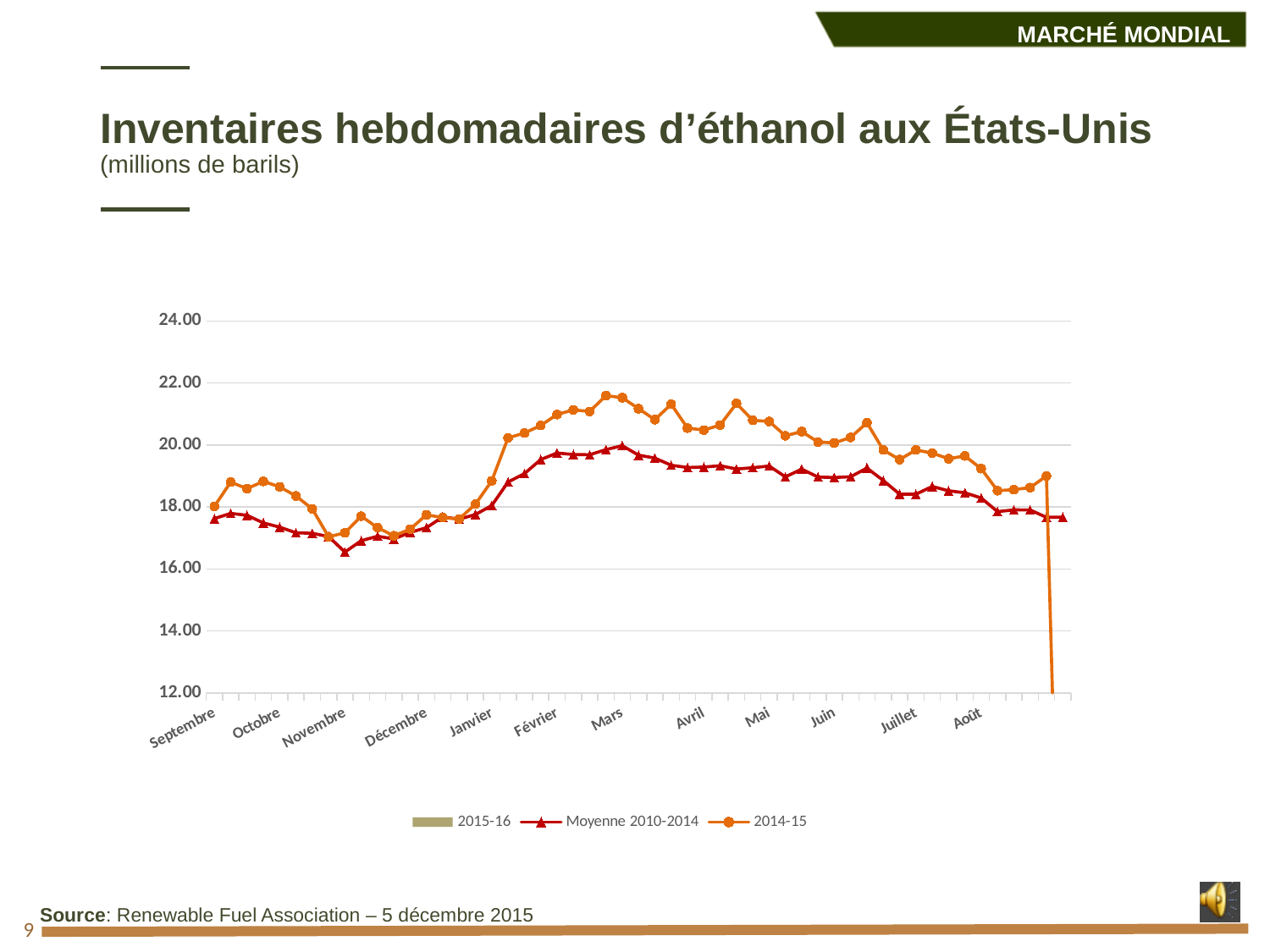
How many series does the legend list? 3 In Mars, which series is higher: 2014-15 or Moyenne 2010-2014? 2014-15 In which month does the Moyenne 2010-2014 series reach its lowest value? Novembre What unit is given under the chart title? millions de barils What kind of chart is shown on the slide? line chart Which series are listed in the legend? 2015-16, Moyenne 2010-2014, 2014-15 Is the value of the Moyenne 2010-2014 series in Avril greater or less than 20.00? less Is the lowest value of the Moyenne 2010-2014 series in Novembre greater or less than 18.00? less Is the peak value of the 2014-15 series in Mars greater or less than 20.00? greater Does the 2014-15 series rise or fall from Novembre to Mars? rise